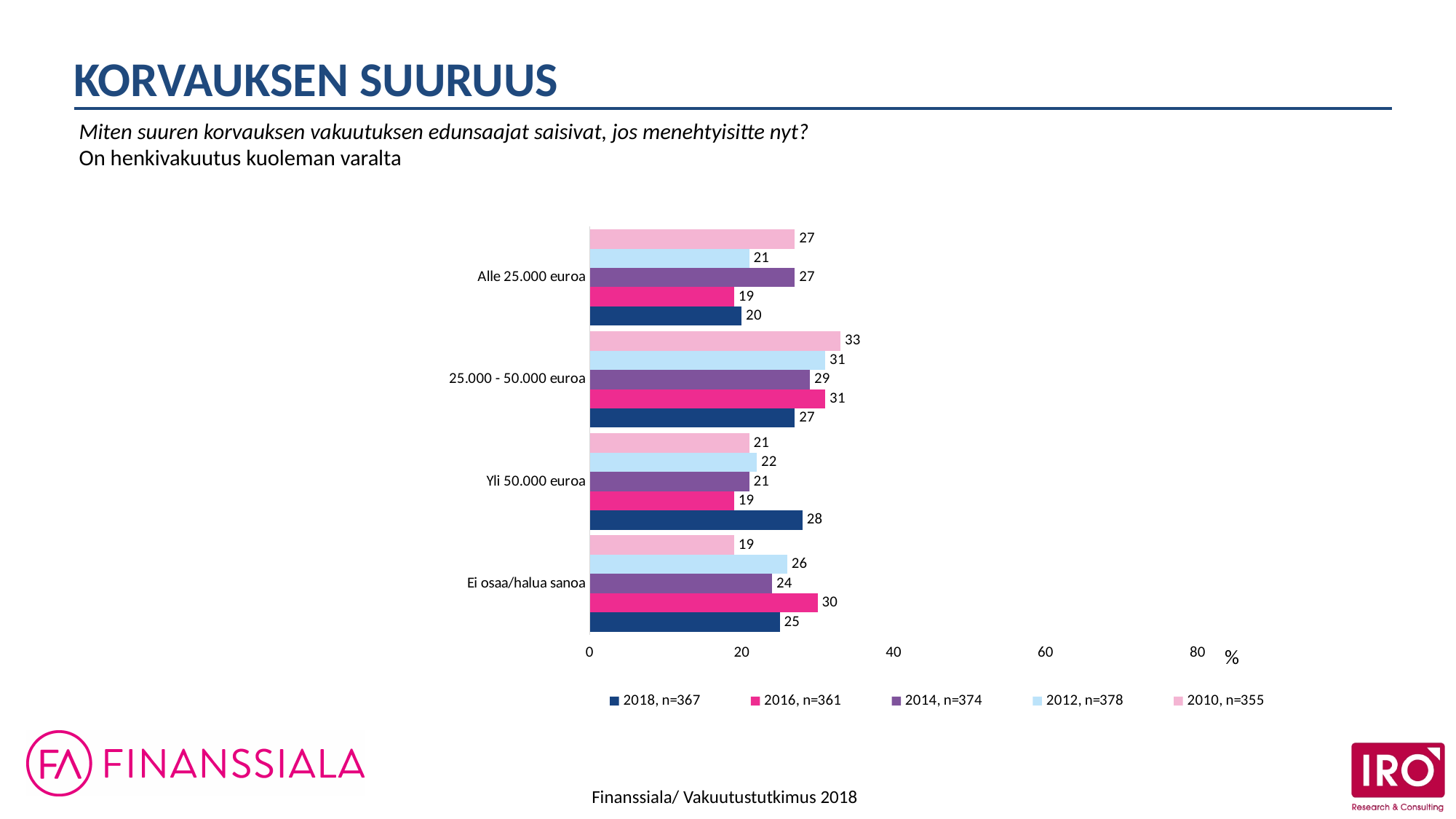
In the "Alle 25.000 euroa" category, which is larger: the 2014 value or the 2012 value? 2014 Which category has the highest value for the 2018 series? Yli 50.000 euroa What is the value for 2010 in the "25.000 - 50.000 euroa" category? 33 What is the value for 2018 in the "Yli 50.000 euroa" category? 28 What is the sample size (n) given in the legend for the 2012 series? n=378 How many categories are shown on the chart? 4 What is the difference between the 2016 and 2018 values in the "Ei osaa/halua sanoa" category? 5 Which category has the lowest value for the 2010 series? Ei osaa/halua sanoa What kind of chart is shown on the slide? bar chart How many series does the legend list? 5 Is the value for 2010 in the "25.000 - 50.000 euroa" category greater or less than 40? less What is the value for 2016 in the "Ei osaa/halua sanoa" category? 30